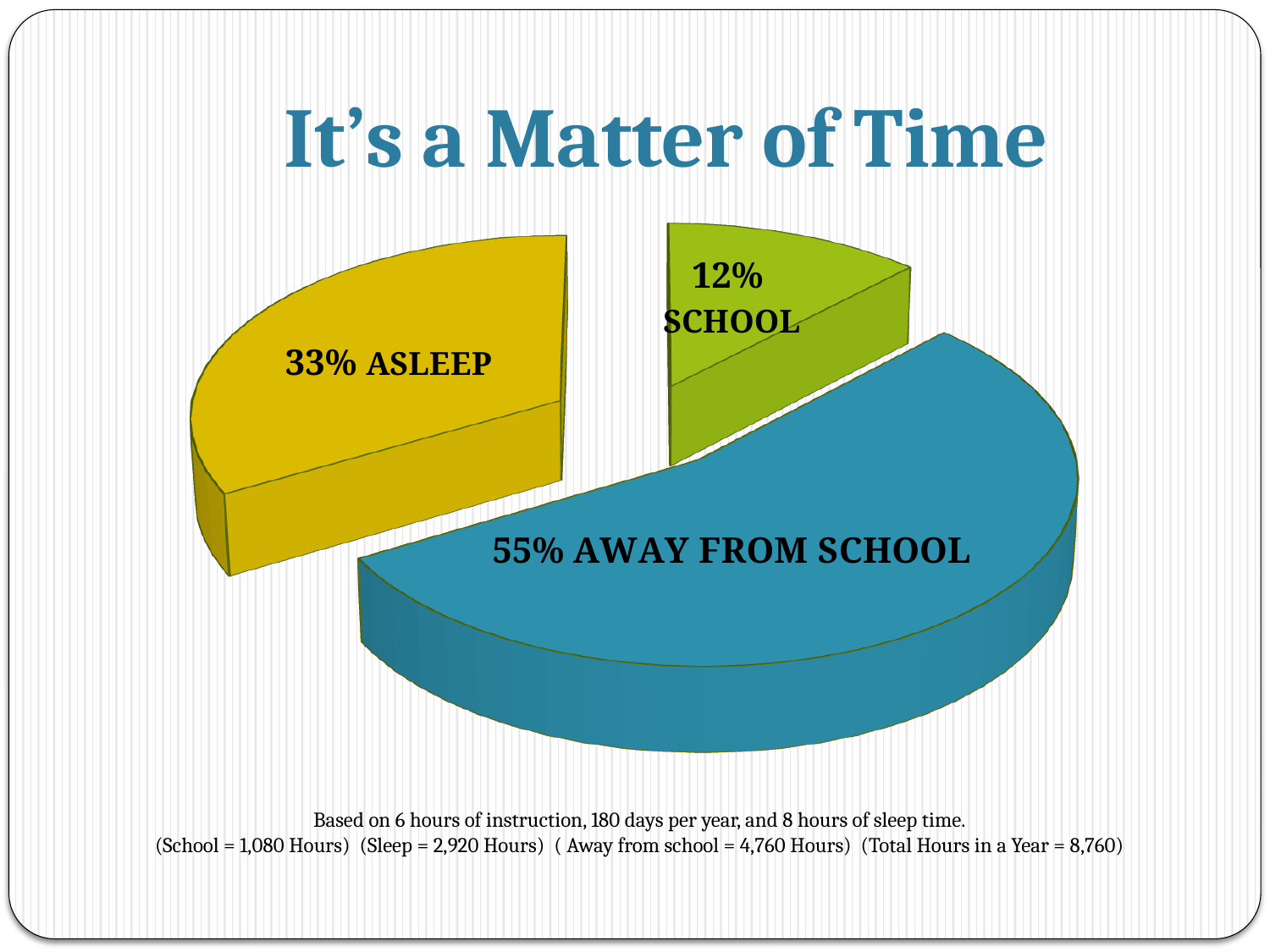
Which slice of the pie is the smallest? SCHOOL What share of the pie is labelled AWAY FROM SCHOOL? 55% What share of the pie is labelled SCHOOL? 12% What colour is the AWAY FROM SCHOOL slice? Blue What kind of chart is shown on the slide? Pie chart How many slices does the pie chart have? 3 Which slice of the pie is the largest? AWAY FROM SCHOOL What share of the pie is labelled ASLEEP? 33% What is the title of the chart on the slide? It's a Matter of Time What is the difference in percentage points between the ASLEEP slice and the SCHOOL slice? 21 What is the difference in percentage points between the AWAY FROM SCHOOL slice and the ASLEEP slice? 22 Which is larger, the ASLEEP slice or the SCHOOL slice? ASLEEP